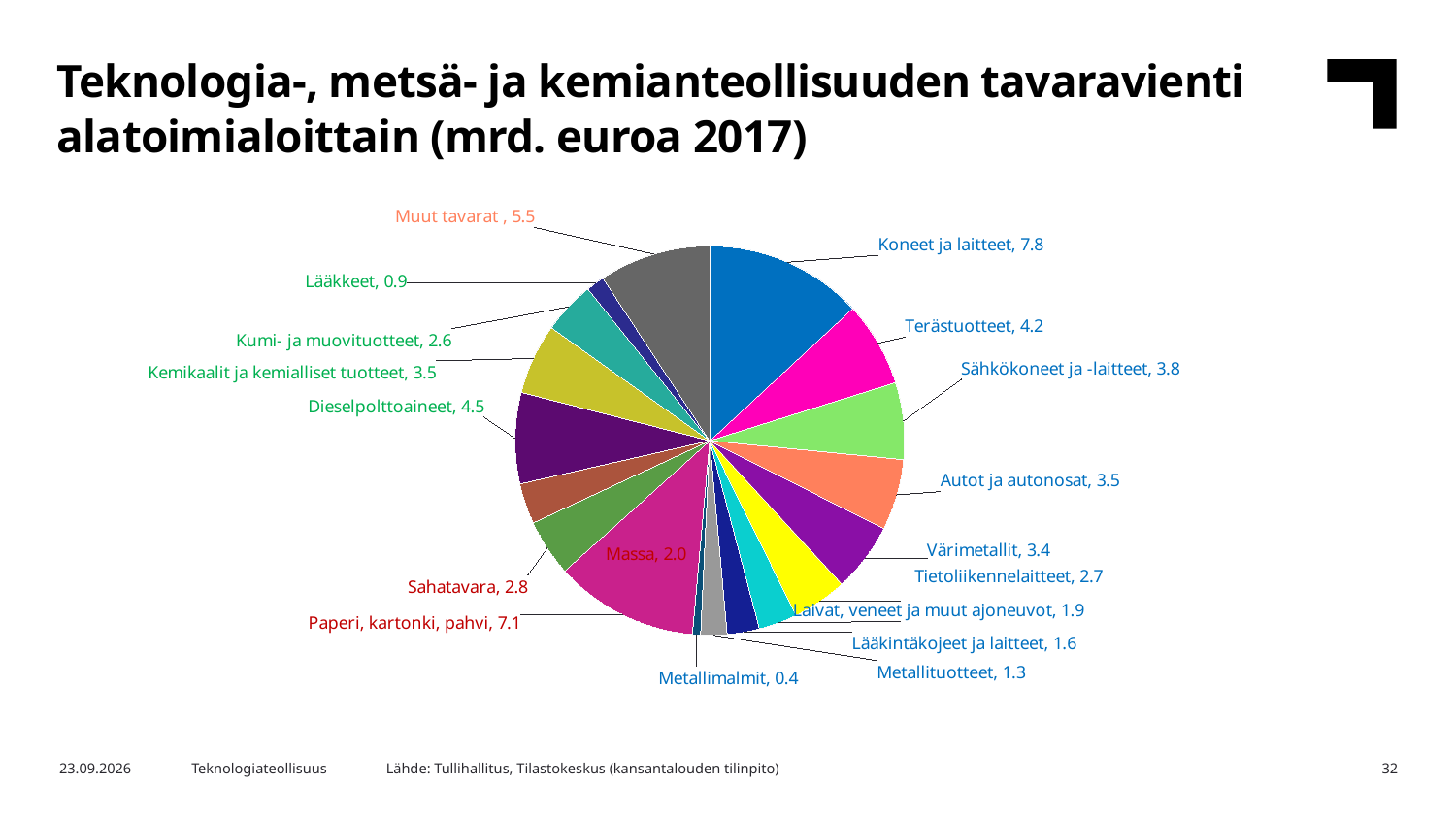
What is the value for Koneet ja laitteet? 7.8 Which category has the largest value in the pie chart? Koneet ja laitteet What is the value for Metallimalmit? 0.4 What is the value for Dieselpolttoaineet? 4.5 Which category has the smallest value in the pie chart? Metallimalmit What is the value for Paperi, kartonki, pahvi? 7.1 What is the title of the chart on the slide? Teknologia-, metsä- ja kemianteollisuuden tavaravienti alatoimialoittain (mrd. euroa 2017) What kind of chart is shown on the slide? pie chart What is the value for Muut tavarat? 5.5 How many categories (slices) does the pie chart have? 18 Which is larger, the value for Terästuotteet or the value for Dieselpolttoaineet? Dieselpolttoaineet What is the difference between the values for Koneet ja laitteet and Paperi, kartonki, pahvi? 0.7